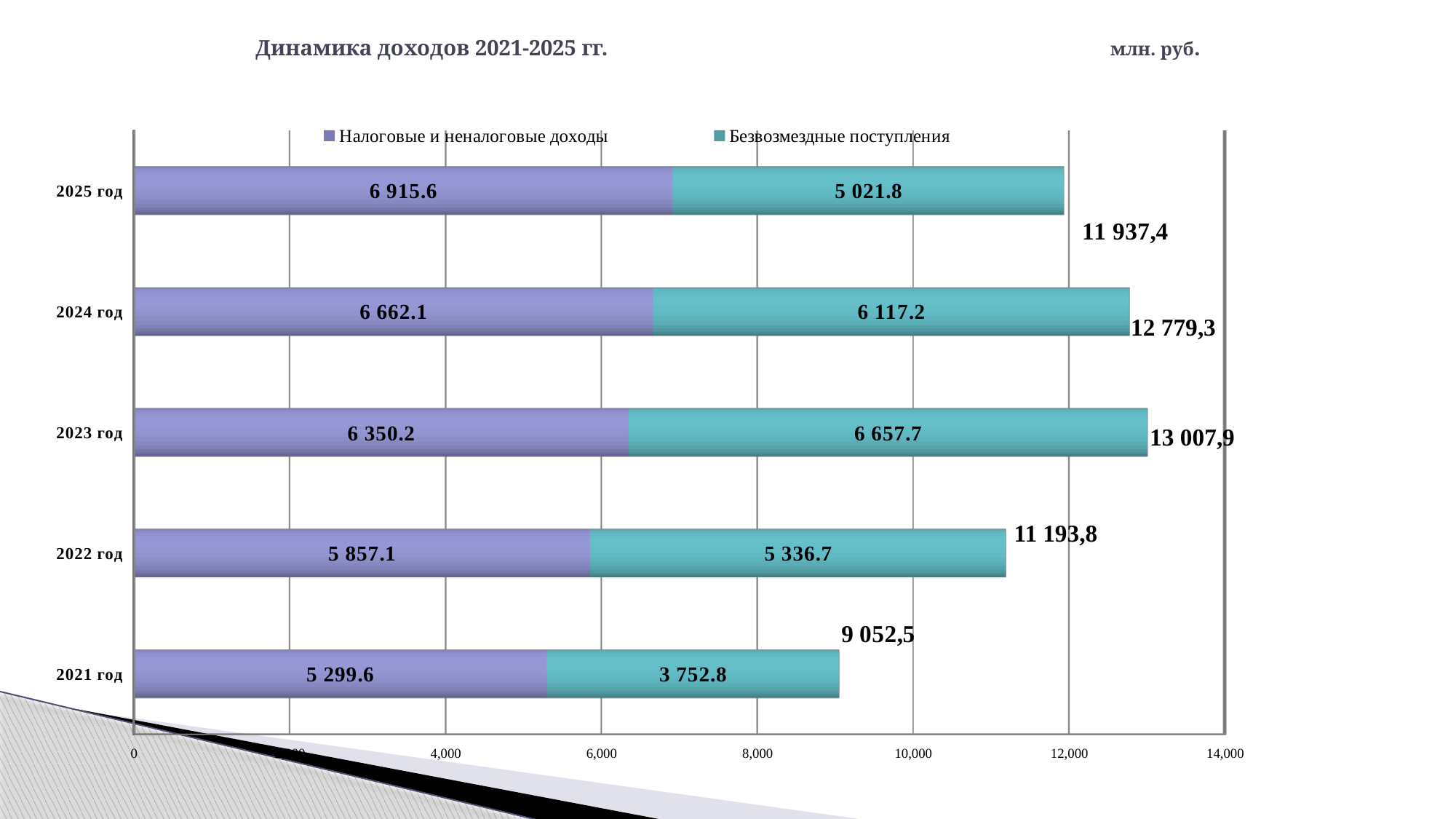
What type of chart is shown on the slide? Stacked bar chart What is the value of Налоговые и неналоговые доходы for 2025 год? 6 915.6 How many series does the legend list? 2 Which year has the lowest value of Безвозмездные поступления? 2021 год What is the difference between Налоговые и неналоговые доходы in 2022 год and 2021 год? 557.5 Which year has the highest value of Налоговые и неналоговые доходы? 2025 год How many years (categories) are shown in the chart? 5 What is the total income shown for 2023 год? 13 007,9 What is the title of the chart? Динамика доходов 2021-2025 гг. Which is larger for 2024 год: Налоговые и неналоговые доходы or Безвозмездные поступления? Налоговые и неналоговые доходы What is the value of Безвозмездные поступления for 2023 год? 6 657.7 What is the value of Безвозмездные поступления for 2021 год? 3 752.8